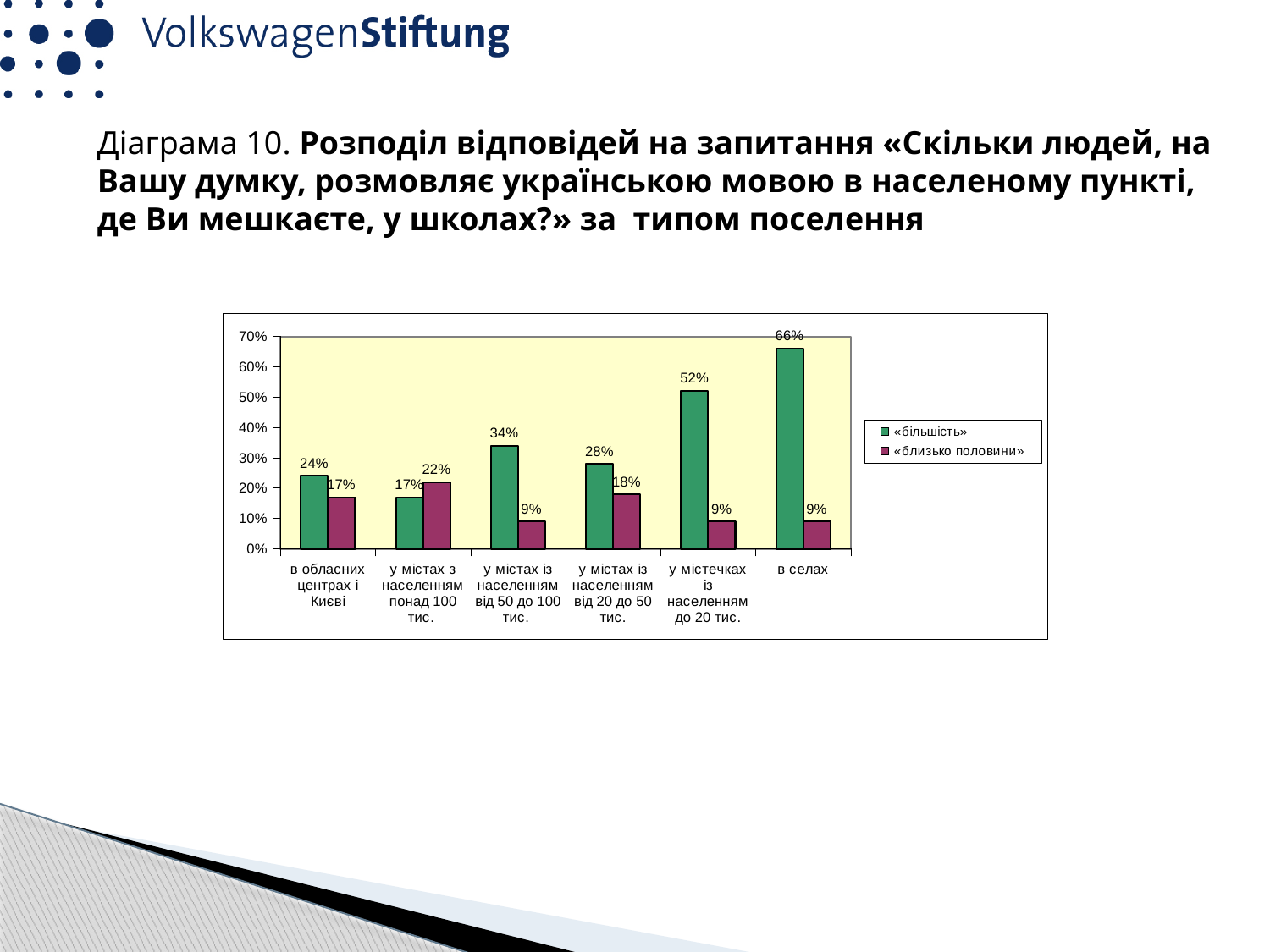
How many series does the legend list? 2 What is the value for «близько половини» in the category «у містах з населенням понад 100 тис.»? 22% What is the value for «більшість» in the category «у містечках із населенням до 20 тис.»? 52% In the category «у містах з населенням понад 100 тис.», which series has the larger value, «більшість» or «близько половини»? «близько половини» What is the difference between the «більшість» and «близько половини» values in the category «в селах»? 57% Which category has the highest value for «більшість»? в селах What is the value for «більшість» in the category «в селах»? 66% What kind of chart is shown on the slide? bar chart Which category has the lowest value for «більшість»? у містах з населенням понад 100 тис. How many categories are shown on the x axis? 6 Does the value for «більшість» rise or fall from «у містах із населенням від 50 до 100 тис.» to «в селах»? rise What colour are the bars for the series «більшість»? green